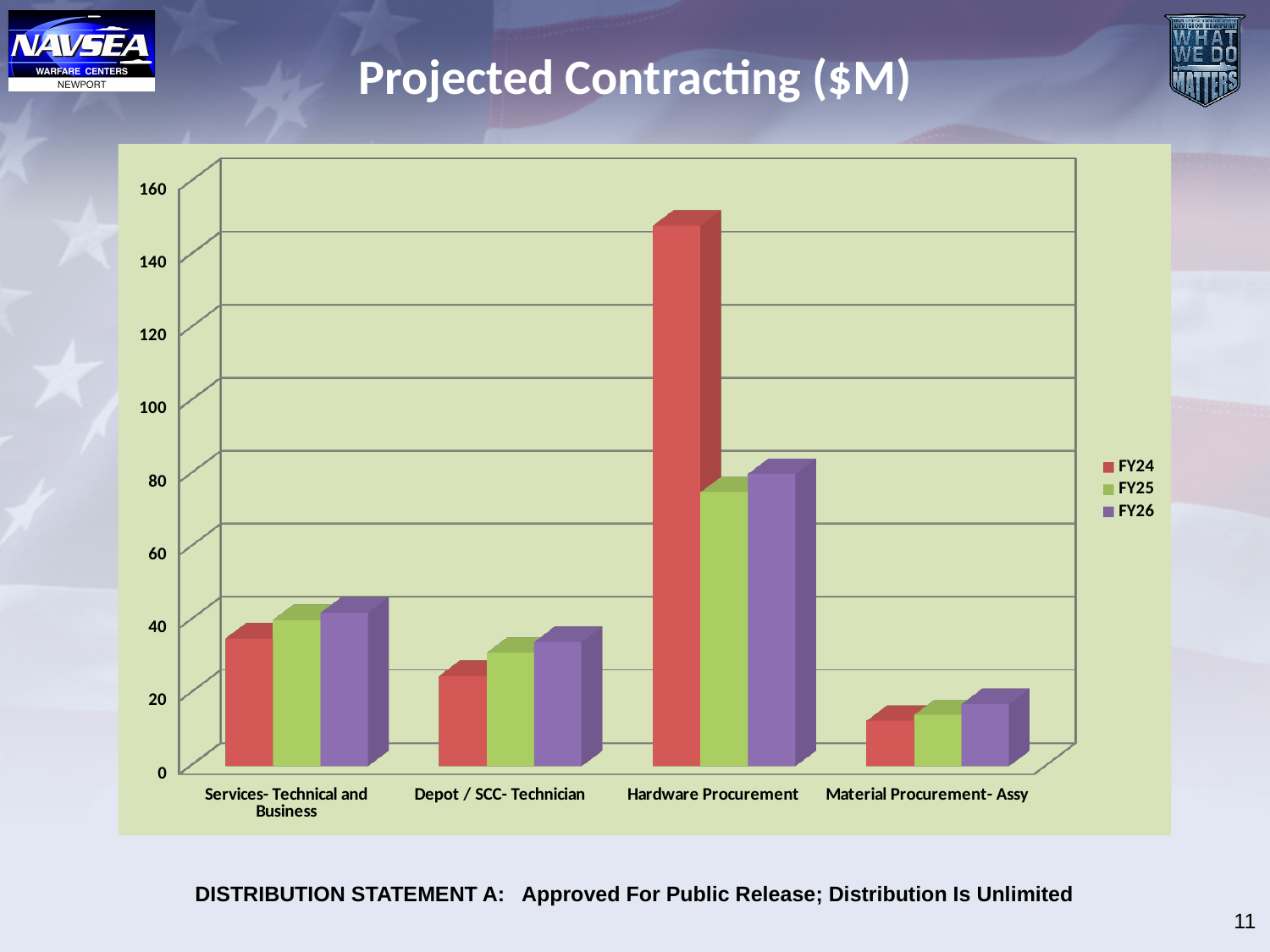
Is the FY24 value for Material Procurement- Assy greater or less than 20? less Is the FY25 value for Hardware Procurement greater or less than 100? less Which category has the lowest FY24 value? Material Procurement- Assy How many categories are shown on the x axis? 4 Which is larger for FY24: Hardware Procurement or Services- Technical and Business? Hardware Procurement What is the title of the chart? Projected Contracting ($M) Which is larger for FY26: Services- Technical and Business or Material Procurement- Assy? Services- Technical and Business Is the FY24 value for Depot / SCC- Technician greater or less than 40? less How many series does the legend list? 3 What type of chart is shown on the slide? bar chart Which category has the highest FY24 value? Hardware Procurement